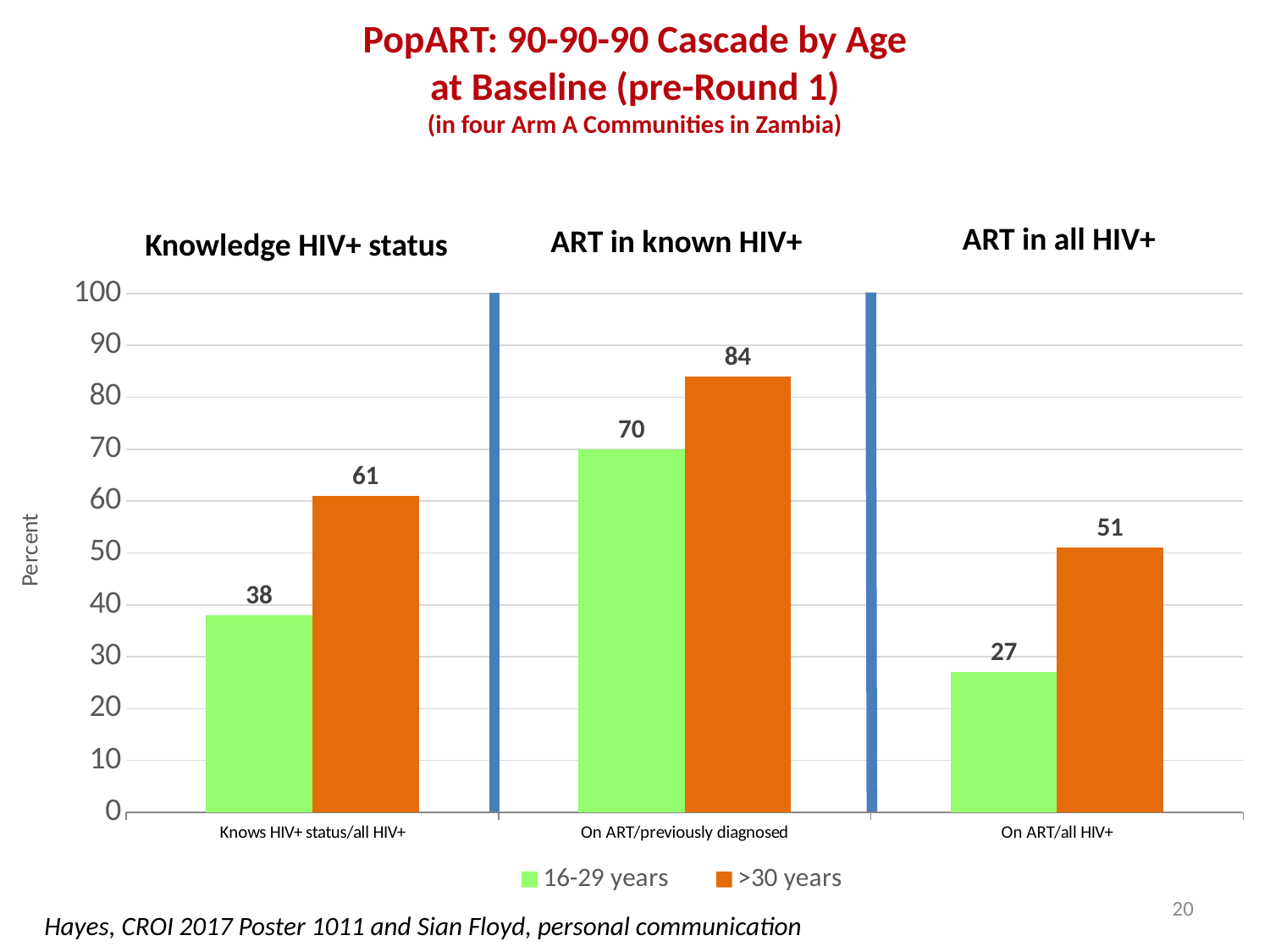
Which category has the lowest value for the 16-29 years series? On ART/all HIV+ What is the difference between the >30 years and 16-29 years values in the On ART/all HIV+ category? 24 How many categories are shown on the x axis? 3 Which is larger in the On ART/previously diagnosed category: the 16-29 years value or the >30 years value? >30 years How many series does the legend list? 2 Which category has the highest value for the >30 years series? On ART/previously diagnosed What is the value for the 16-29 years series in the On ART/all HIV+ category? 27 What is the difference between the >30 years and 16-29 years values in the Knows HIV+ status/all HIV+ category? 23 What is the value for the 16-29 years series in the Knows HIV+ status/all HIV+ category? 38 What is the value for the >30 years series in the On ART/previously diagnosed category? 84 What is the label of the y axis? Percent What kind of chart is shown on the slide? Bar chart